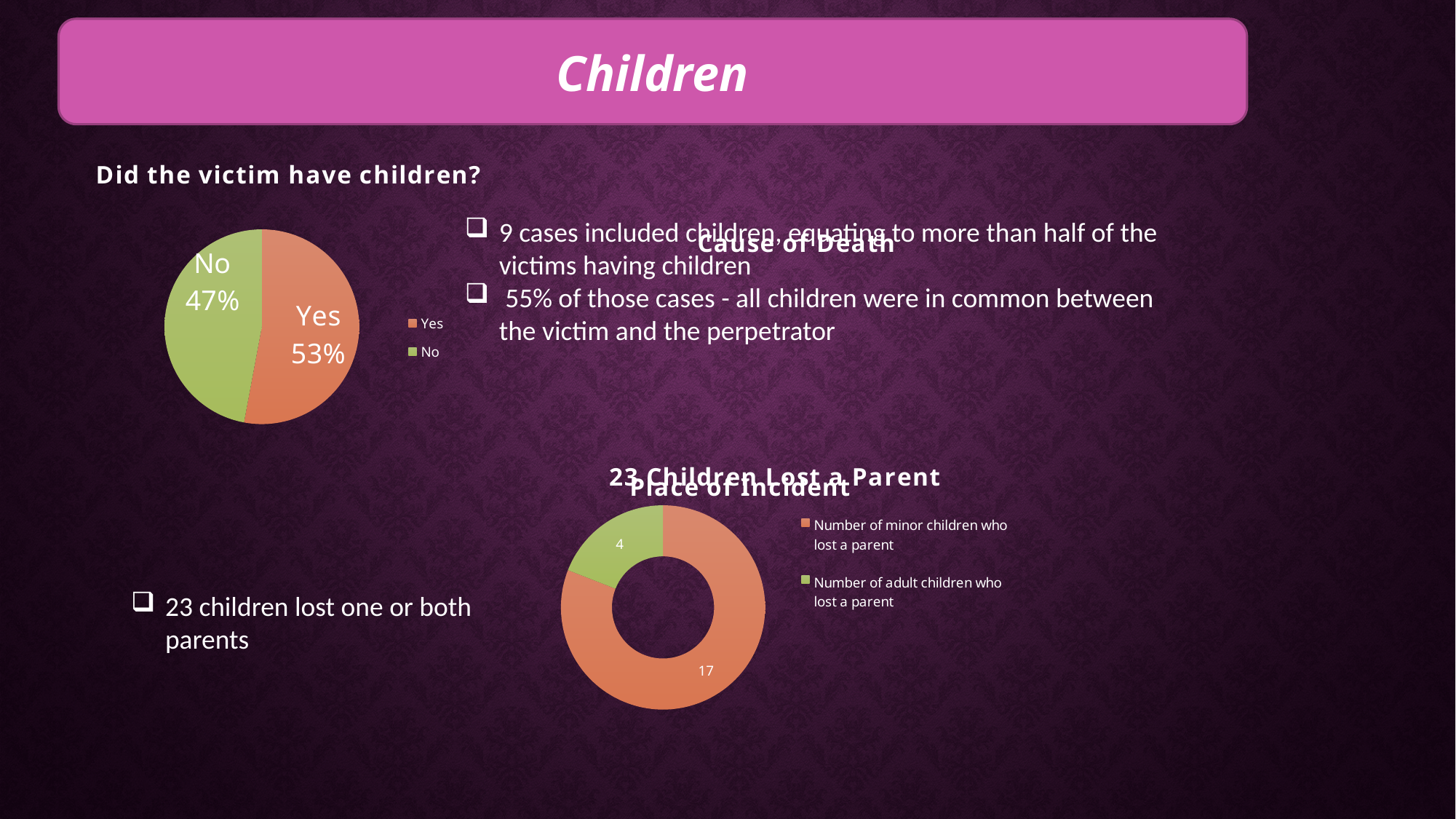
In the '23 Children Lost a Parent' chart, how many minor children lost a parent? 17 In the 'Did the victim have children?' pie chart, which category has the larger share? Yes In the 'Did the victim have children?' pie chart, what percentage is shown for No? 47% In the 'Did the victim have children?' pie chart, what is the difference in percentage points between Yes and No? 6 In the '23 Children Lost a Parent' chart, what colour is the segment for minor children who lost a parent? Orange In the 'Did the victim have children?' pie chart, what percentage of victims had children (Yes)? 53% What kind of chart is the 'Did the victim have children?' chart? Pie chart In the '23 Children Lost a Parent' chart, what is the total of the two segments? 21 In the '23 Children Lost a Parent' chart, which category is smallest? Number of adult children who lost a parent How many entries does the legend of the 'Did the victim have children?' chart list? 2 In the '23 Children Lost a Parent' chart, what is the difference between the number of minor children and adult children who lost a parent? 13 In the '23 Children Lost a Parent' chart, how many adult children lost a parent? 4